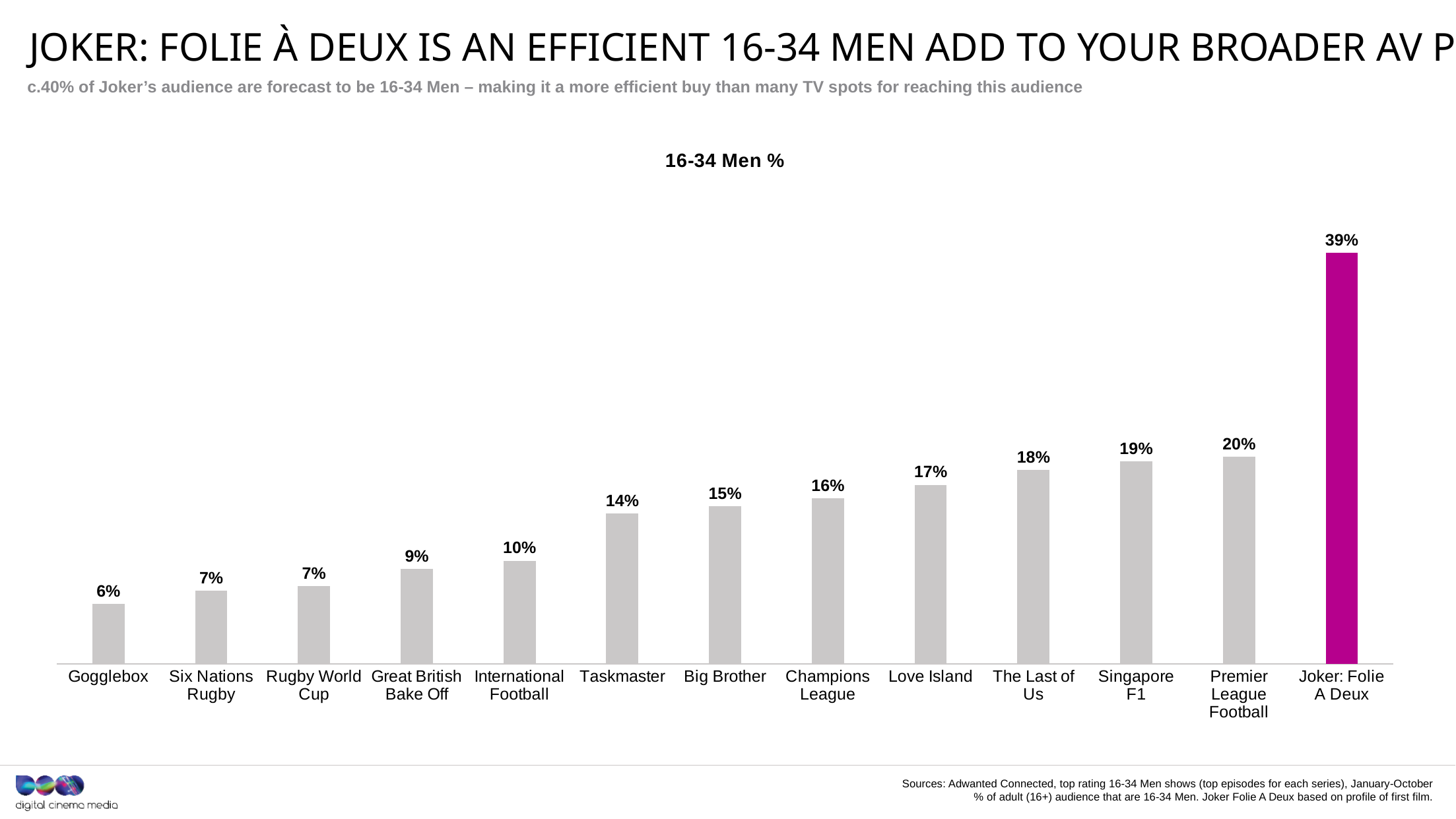
What kind of chart is shown on the slide? Bar chart What is the 16-34 Men % value for Premier League Football? 20% Which category has the lowest 16-34 Men %? Gogglebox Do the values generally rise or fall from left to right along the x axis? Rise What is the 16-34 Men % value for Joker: Folie A Deux? 39% What is the difference between the 16-34 Men % for Joker: Folie A Deux and Premier League Football? 19% What is the 16-34 Men % value for Taskmaster? 14% Which has a higher 16-34 Men %, Big Brother or International Football? Big Brother Which category has the highest 16-34 Men %? Joker: Folie A Deux How many categories are shown on the chart? 13 What is the title of the chart? 16-34 Men % What is the difference between the 16-34 Men % for Love Island and Great British Bake Off? 8%